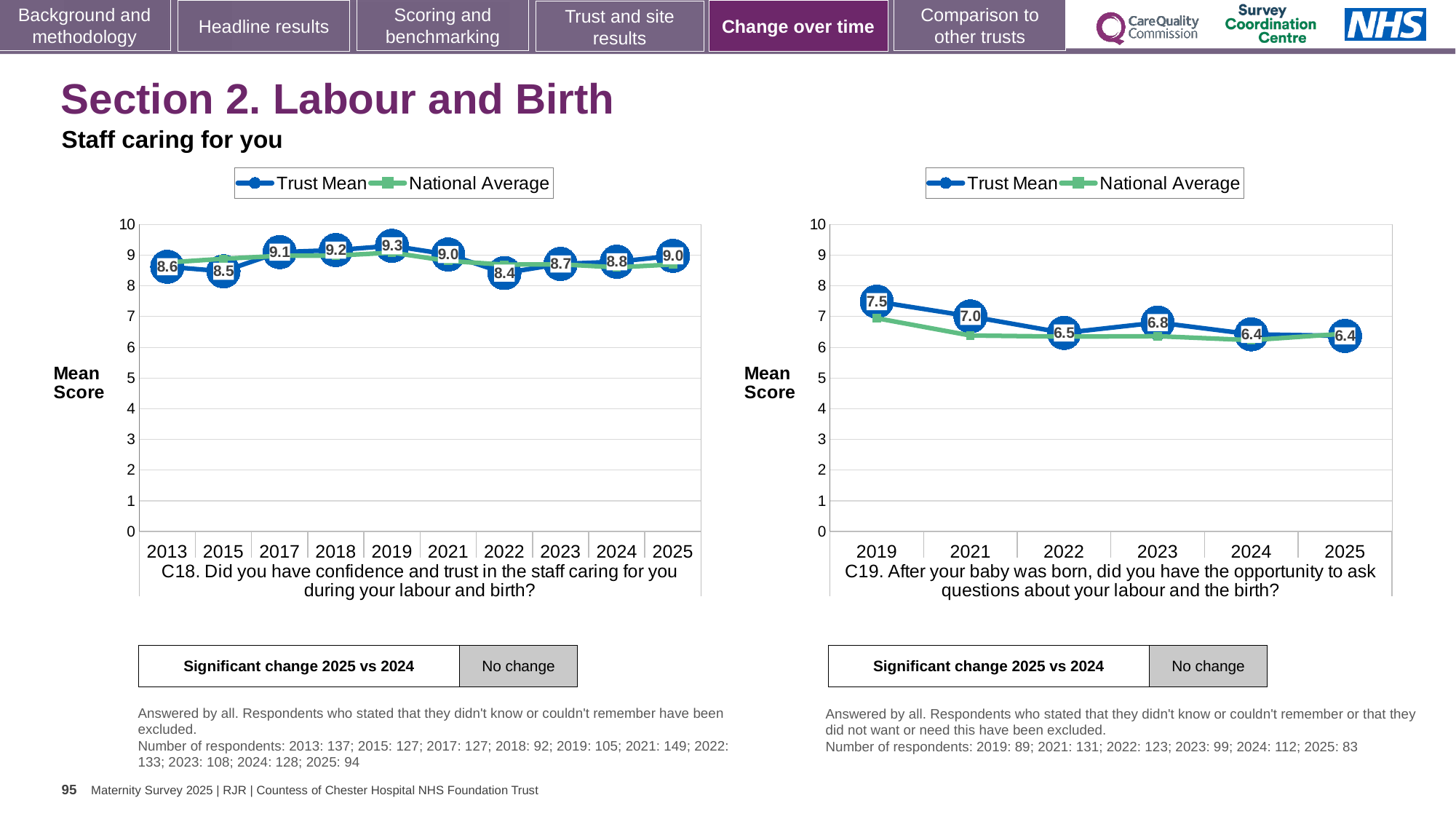
In the C19 chart, what is the difference between the Trust Mean scores for 2019 and 2025? 1.1 In the C18 chart, how many years are plotted on the x axis? 10 In the C18 chart, which year has the lowest Trust Mean score? 2022 In the C18 chart, what is the difference between the Trust Mean scores for 2025 and 2024? 0.2 In the C19 chart, is the National Average value for 2019 greater or less than 6? greater In the C19 chart, which year has the highest Trust Mean score? 2019 In the C18 chart, which year has the highest Trust Mean score? 2019 In the C18 chart, what is the Trust Mean score for 2022? 8.4 How many series does the legend of the C19 chart list? 2 In the C19 chart, what is the Trust Mean score for 2021? 7.0 In the C18 chart, what is the Trust Mean score for 2019? 9.3 In the C19 chart, is the Trust Mean score for 2023 larger or smaller than the score for 2022? larger